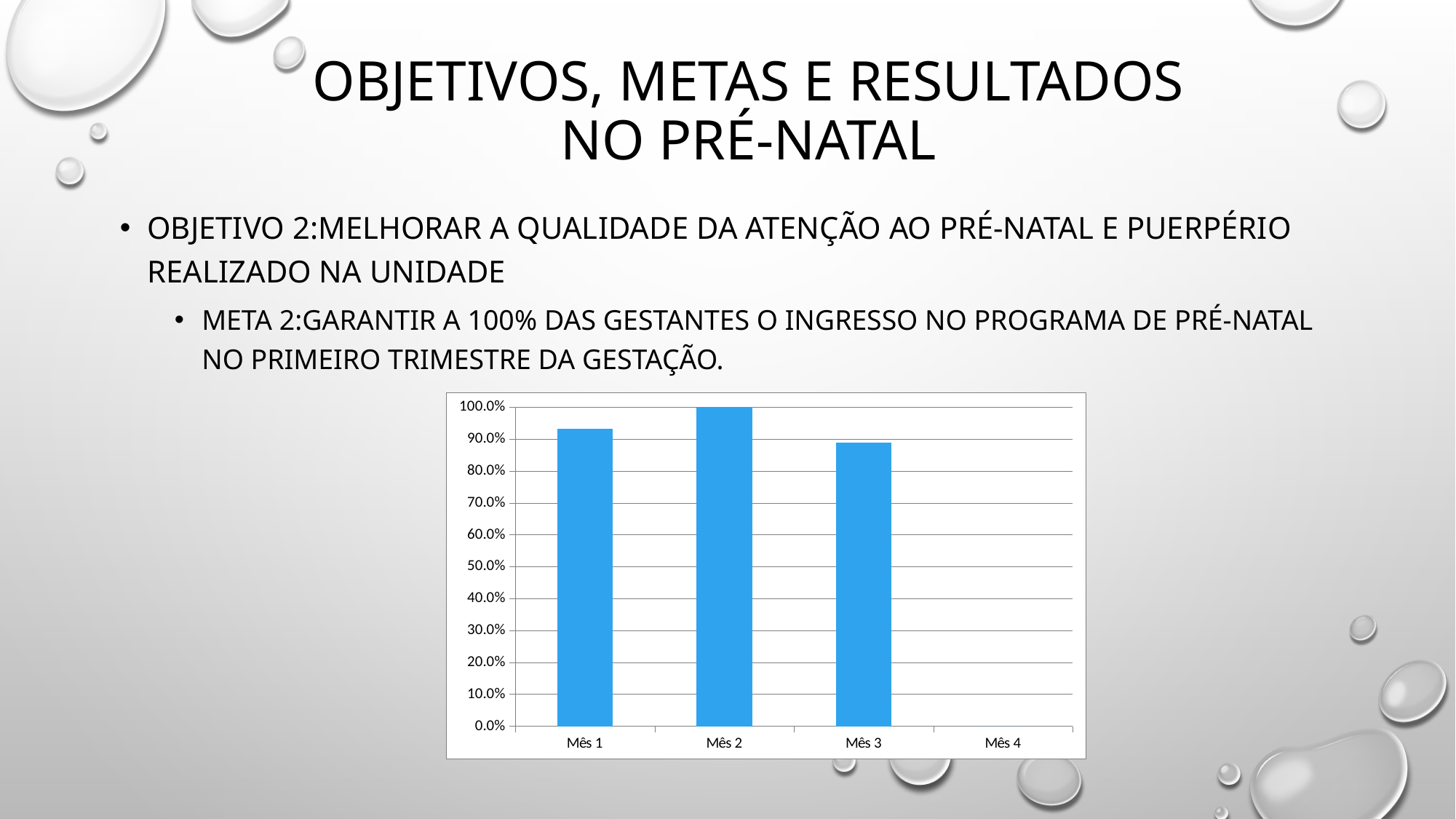
Which month has the highest bar in the chart? Mês 2 Which is larger, the value for Mês 1 or the value for Mês 3? Mês 1 What is the highest tick value shown on the y axis of the chart? 100.0% Which is larger, the value for Mês 2 or the value for Mês 1? Mês 2 Is the value for Mês 3 greater or less than 90.0%? less Do the values rise or fall from Mês 2 to Mês 3? fall What is the value for Mês 2 in the chart? 100.0% Which month on the x axis has no bar shown in the chart? Mês 4 How many categories are shown on the x axis of the chart? 4 What kind of chart is shown on the slide? bar chart Is the value for Mês 1 greater or less than 90.0%? greater Is the value for Mês 1 greater or less than 100.0%? less